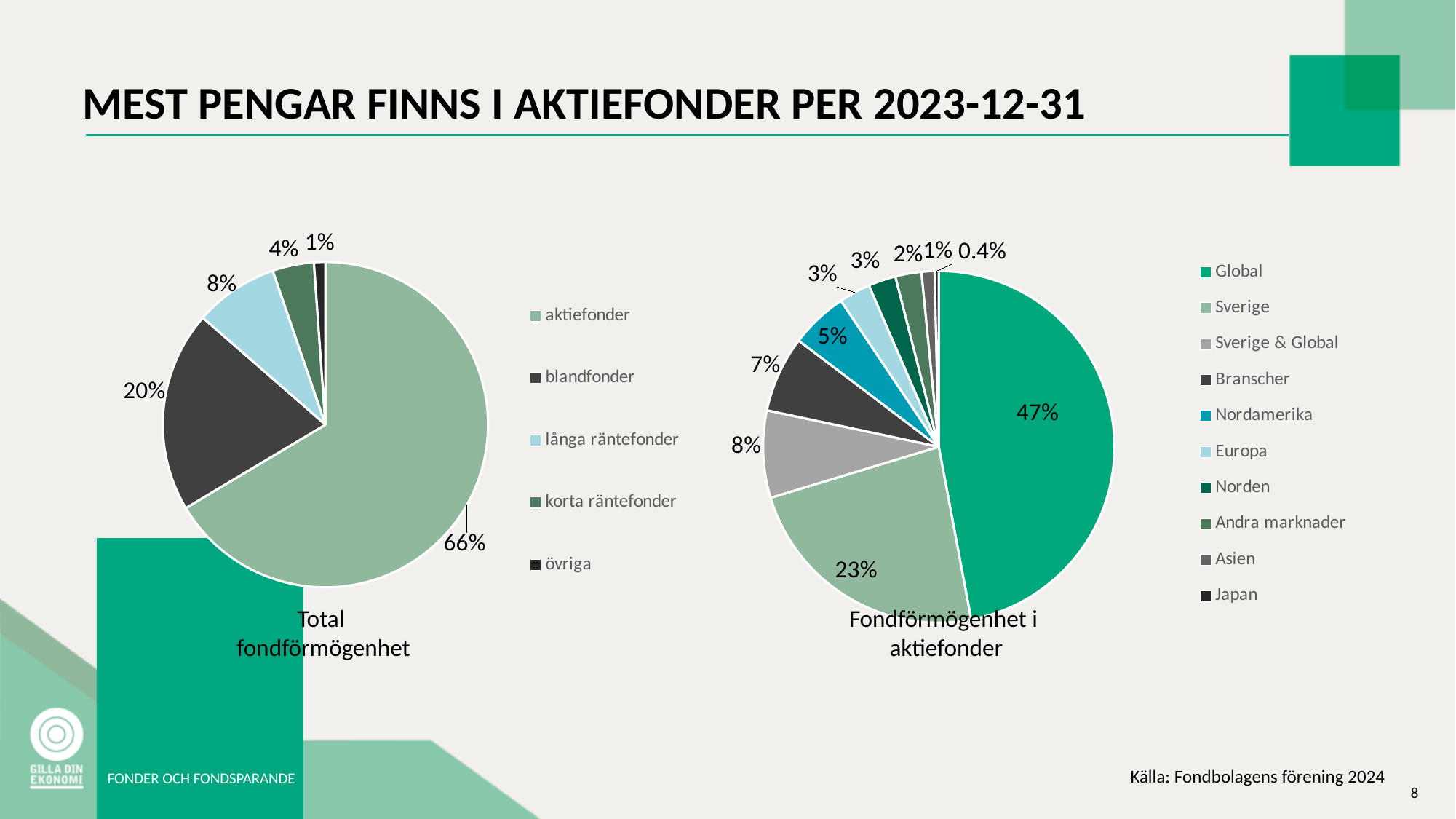
How many categories does the legend of the 'Fondförmögenhet i aktiefonder' chart list? 10 In the 'Fondförmögenhet i aktiefonder' chart, what share is Japan? 0.4% In the 'Fondförmögenhet i aktiefonder' chart, which category has the largest share? Global In the 'Fondförmögenhet i aktiefonder' chart, what share is Sverige? 23% In the 'Total fondförmögenhet' chart, what share is blandfonder? 20% In the 'Fondförmögenhet i aktiefonder' chart, what share is Global? 47% In the 'Fondförmögenhet i aktiefonder' chart, which is larger: Branscher or Nordamerika? Branscher In the 'Total fondförmögenhet' chart, what share is aktiefonder? 66% How many categories does the legend of the 'Total fondförmögenhet' chart list? 5 In the 'Total fondförmögenhet' chart, what is the difference between the shares of blandfonder and långa räntefonder? 12% What type of chart is the 'Total fondförmögenhet' chart? Pie chart In the 'Total fondförmögenhet' chart, which category has the smallest share? övriga